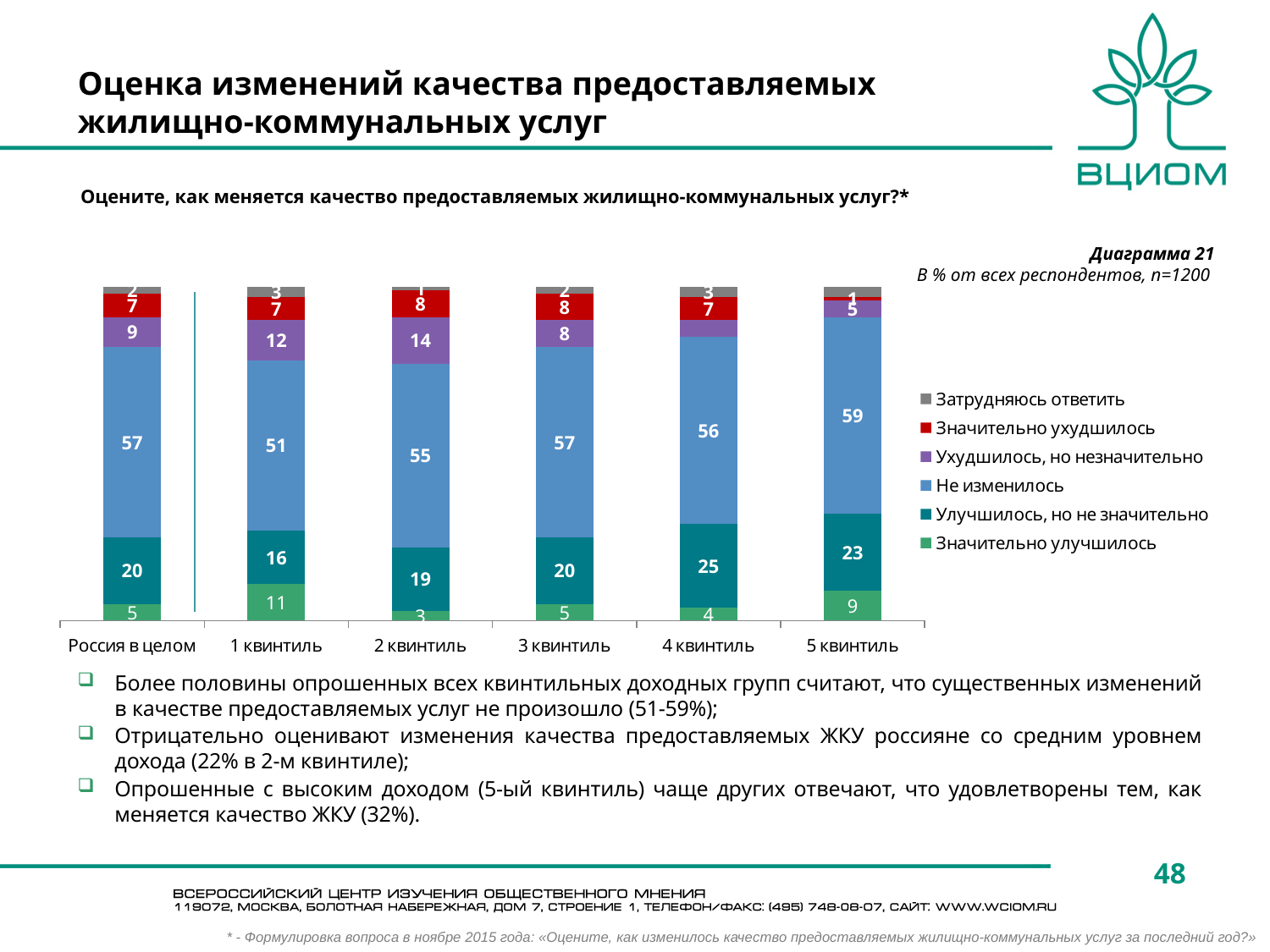
What is the value of "Ухудшилось, но незначительно" for "2 квинтиль"? 14 What is the value of "Значительно улучшилось" for "1 квинтиль"? 11 Which is larger: the "Значительно ухудшилось" value for "2 квинтиль" or for "5 квинтиль"? 2 квинтиль What kind of chart is shown on the slide? stacked bar chart What is the number of the diagram given in the chart caption? Диаграмма 21 Which category has the highest value for "Не изменилось"? 5 квинтиль What is the total of the stacked bar for "Россия в целом"? 100 How many series does the chart legend list? 6 How many categories are shown along the x axis of the chart? 6 What is the difference between the "Улучшилось, но не значительно" values for "4 квинтиль" and "1 квинтиль"? 9 Which category has the lowest value for "Значительно улучшилось"? 2 квинтиль What is the value of "Не изменилось" for "5 квинтиль"? 59